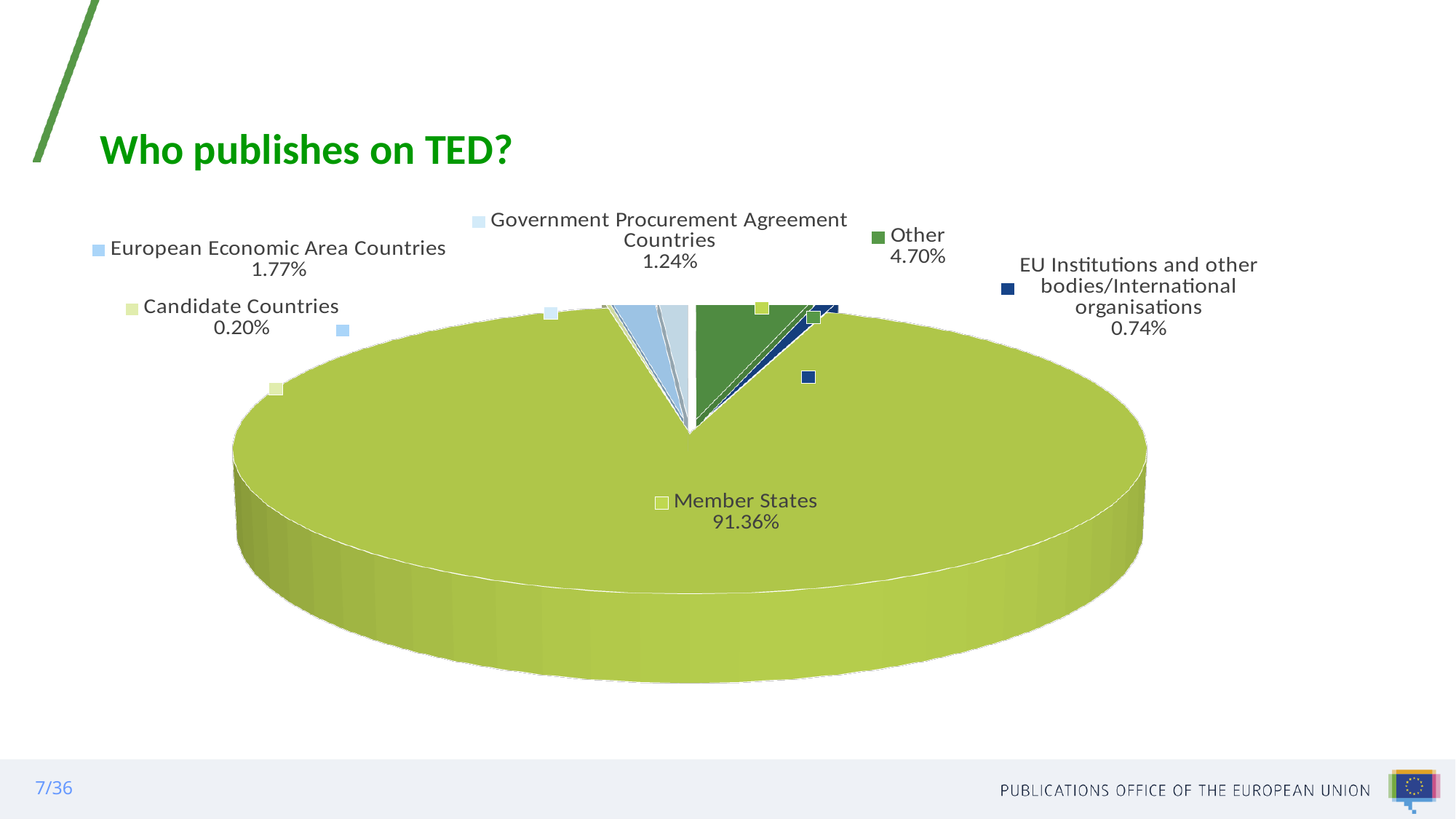
What is the value shown for EU Institutions and other bodies/International organisations? 0.74% What is the value shown for Government Procurement Agreement Countries? 1.24% Which category has the largest slice of the pie? Member States What share of the pie do Member States account for? 91.36% Which category has the smallest slice of the pie? Candidate Countries What is the difference in percentage points between Other and European Economic Area Countries? 2.93 What is the value shown for Candidate Countries? 0.20% Which is larger, the share for European Economic Area Countries or the share for Government Procurement Agreement Countries? European Economic Area Countries What kind of chart is shown on the slide? Pie chart What is the value shown for Other? 4.70% What is the value shown for European Economic Area Countries? 1.77% How many categories are shown in the pie chart? 6